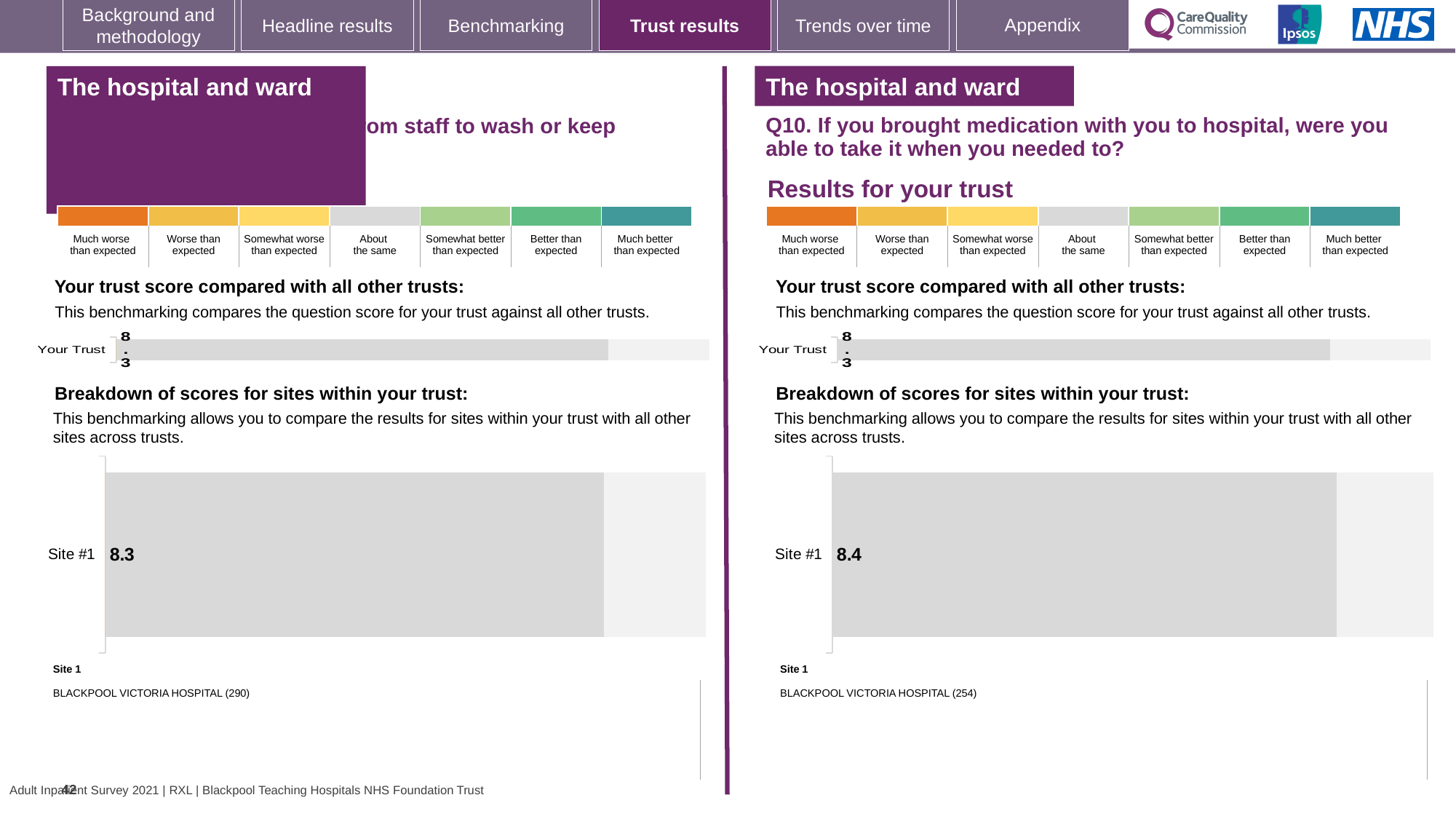
On the left-hand 'Your trust score compared with all other trusts' chart, what is the score shown for Your Trust? 8.3 How many sites are shown on the right-hand 'Breakdown of scores for sites within your trust' chart? 1 How many rating categories are shown in the colour scale above the right-hand 'Your trust score compared with all other trusts' chart? 7 On the right-hand (Q10) side, which hospital is listed as Site 1 and how many respondents are shown in brackets? BLACKPOOL VICTORIA HOSPITAL (254) What kind of chart is used for the 'Breakdown of scores for sites within your trust' on the right-hand side? Bar chart On the left-hand 'Breakdown of scores for sites within your trust' chart, what is the score for Site #1? 8.3 On the right-hand (Q10) side, which is larger: the Your Trust score or the Site #1 score? Site #1 On the right-hand chart for Q10 'Your trust score compared with all other trusts', what is the score shown for Your Trust? 8.3 On the right-hand 'Breakdown of scores for sites within your trust' chart (Q10), what is the score for Site #1? 8.4 Which is larger: the Site #1 score on the left-hand site breakdown chart or the Site #1 score on the right-hand (Q10) site breakdown chart? Right-hand (Q10) chart What is the difference between the Site #1 score on the right-hand (Q10) site breakdown chart and the Site #1 score on the left-hand site breakdown chart? 0.1